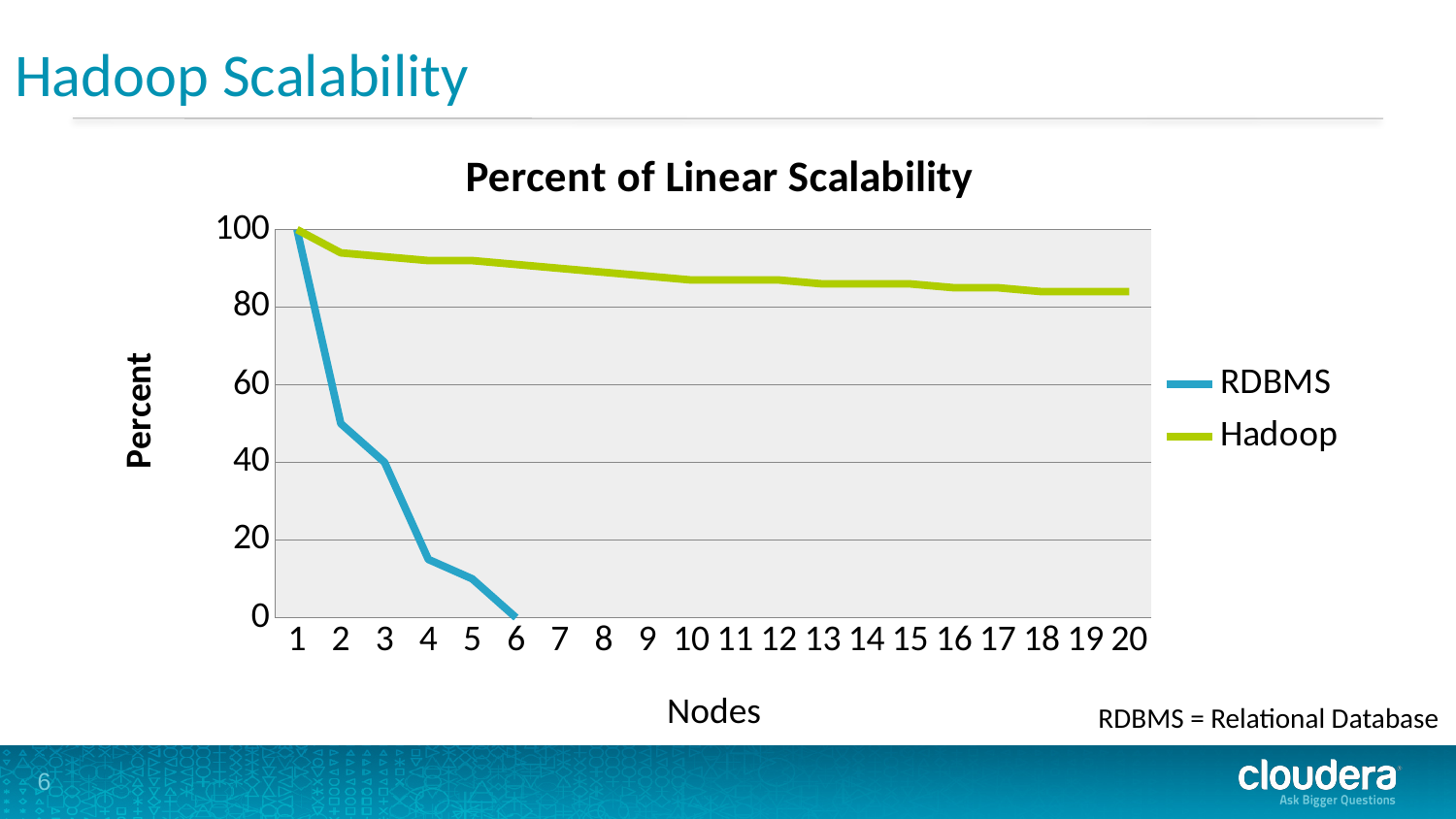
Does the RDBMS line rise or fall as the number of nodes increases? Fall How many series does the legend list? 2 Is the RDBMS value at 4 nodes greater or less than 20? less What is the title of the chart? Percent of Linear Scalability Which series has the higher value at 5 nodes, RDBMS or Hadoop? Hadoop How many node values are shown along the x axis? 20 What is the RDBMS value at 1 node? 100 What is the label of the x axis? Nodes What is the Hadoop value at 1 node? 100 What is the RDBMS value at 6 nodes? 0 What type of chart is shown on the slide? Line chart Is the Hadoop value at 20 nodes greater or less than 80? greater